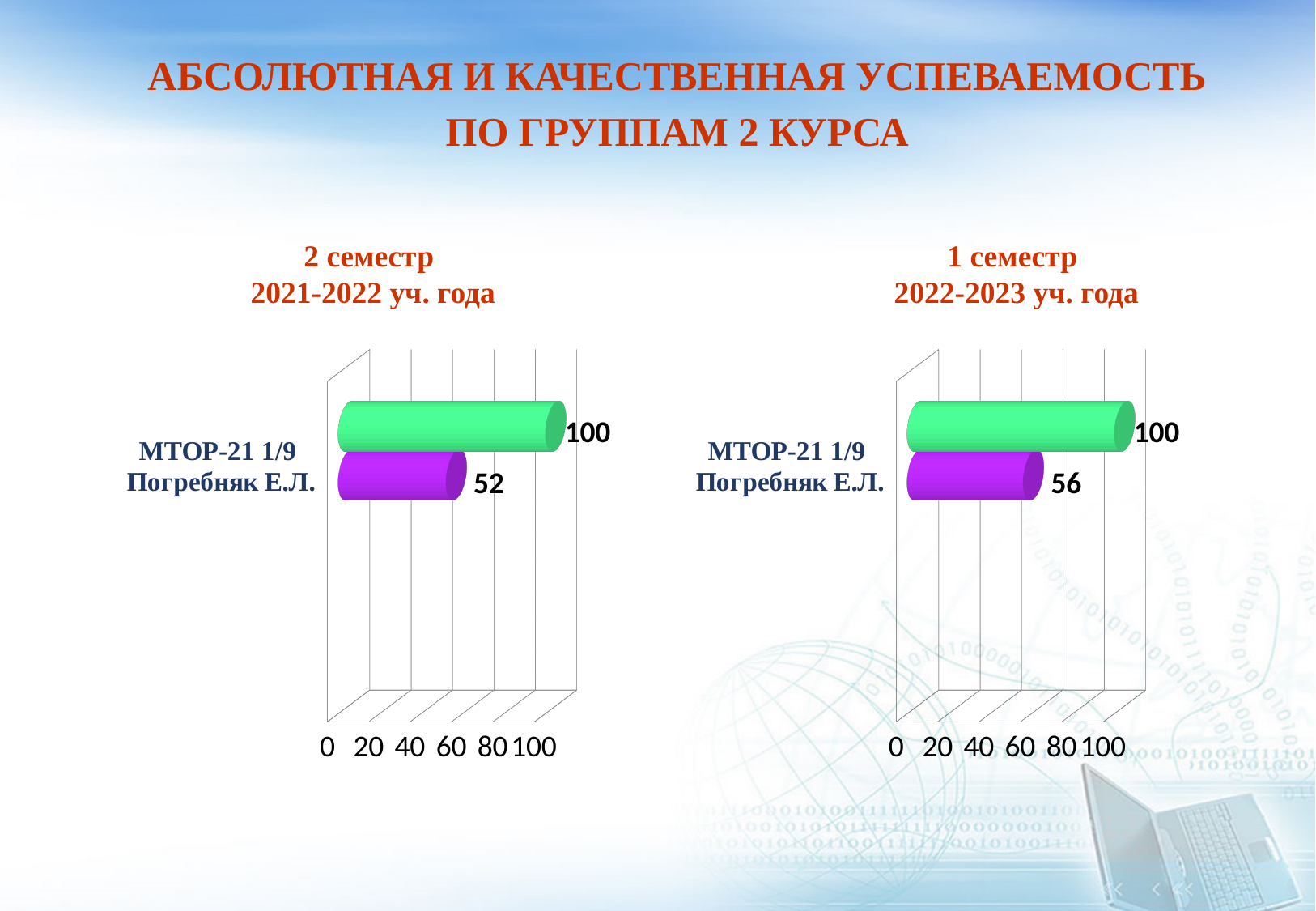
In the left chart (2 семестр 2021-2022 уч. года), which bar is higher, the green one or the purple one? the green one In the left chart (2 семестр 2021-2022 уч. года), what is the difference between the green bar value and the purple bar value? 48 Comparing the purple bars, which chart shows the larger value: the left chart (2 семестр 2021-2022) or the right chart (1 семестр 2022-2023)? the right chart (1 семестр 2022-2023) In the right chart (1 семестр 2022-2023 уч. года), what is the difference between the green bar value and the purple bar value? 44 How many categories are shown on the y axis of the right chart (1 семестр 2022-2023 уч. года)? 1 In the right chart (1 семестр 2022-2023 уч. года), is the purple bar value greater or less than 60? less In the right chart (1 семестр 2022-2023 уч. года), what value is shown on the purple bar for МТОР-21 1/9 Погребняк Е.Л.? 56 In the left chart (2 семестр 2021-2022 уч. года), what value is shown on the green bar for МТОР-21 1/9 Погребняк Е.Л.? 100 What kind of chart is the left chart (2 семестр 2021-2022 уч. года)? bar chart What is the highest tick value shown on the x axis of the left chart (2 семестр 2021-2022 уч. года)? 100 In the right chart (1 семестр 2022-2023 уч. года), what value is shown on the green bar for МТОР-21 1/9 Погребняк Е.Л.? 100 In the left chart (2 семестр 2021-2022 уч. года), what value is shown on the purple bar for МТОР-21 1/9 Погребняк Е.Л.? 52